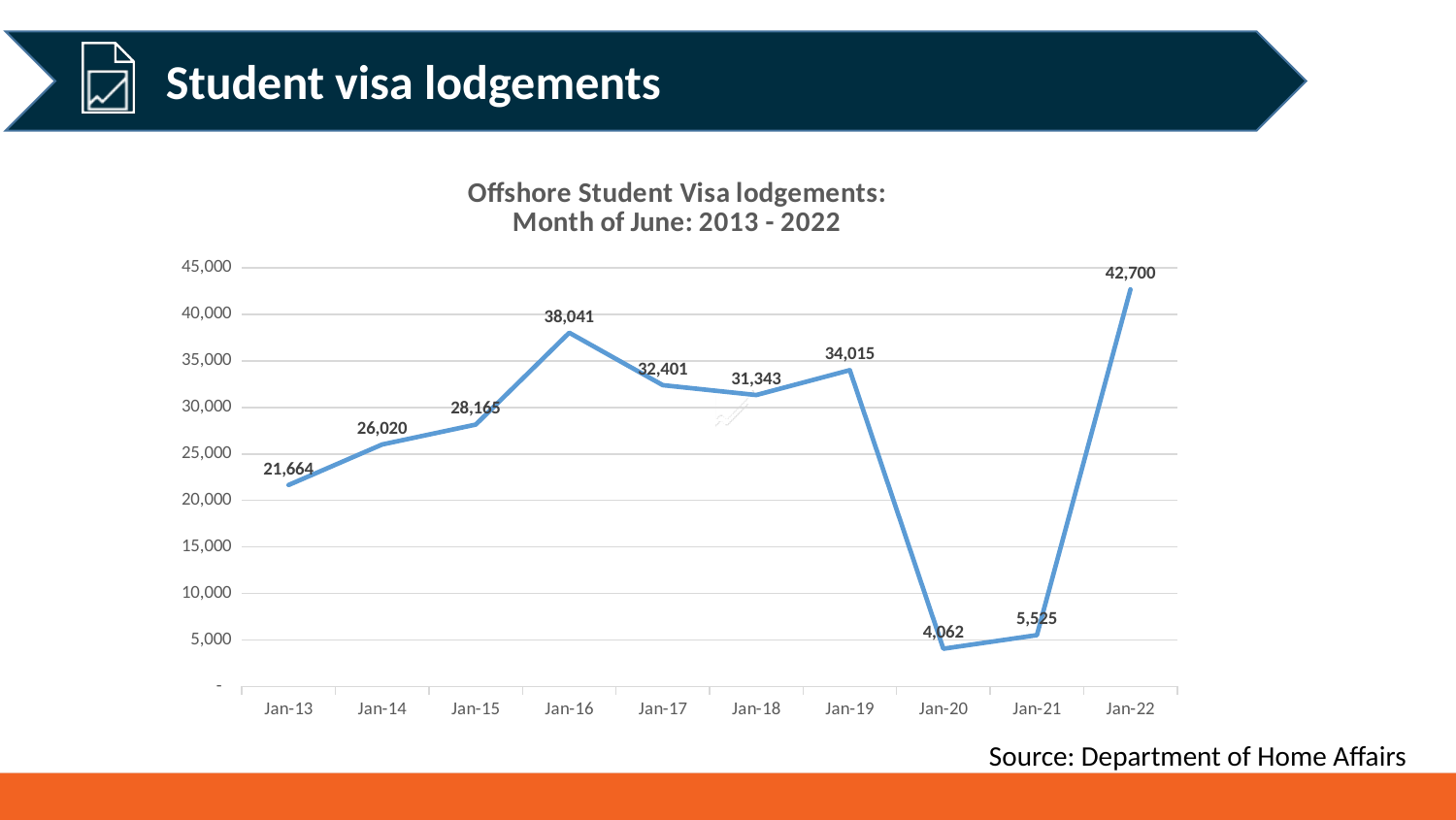
Is the value for Jan-19 greater or less than 30,000? greater What is the title of the chart? Offshore Student Visa lodgements: Month of June: 2013 - 2022 Which point has the highest value? Jan-22 What is the value for Jan-16? 38,041 What is the difference between the values for Jan-16 and Jan-15? 9,876 What is the value for Jan-20? 4,062 Which point has the lowest value? Jan-20 What kind of chart is shown on the slide? line chart What is the value for Jan-13? 21,664 Which is larger, the value for Jan-17 or the value for Jan-18? Jan-17 What is the difference between the values for Jan-22 and Jan-21? 37,175 How many data points are plotted on the chart? 10